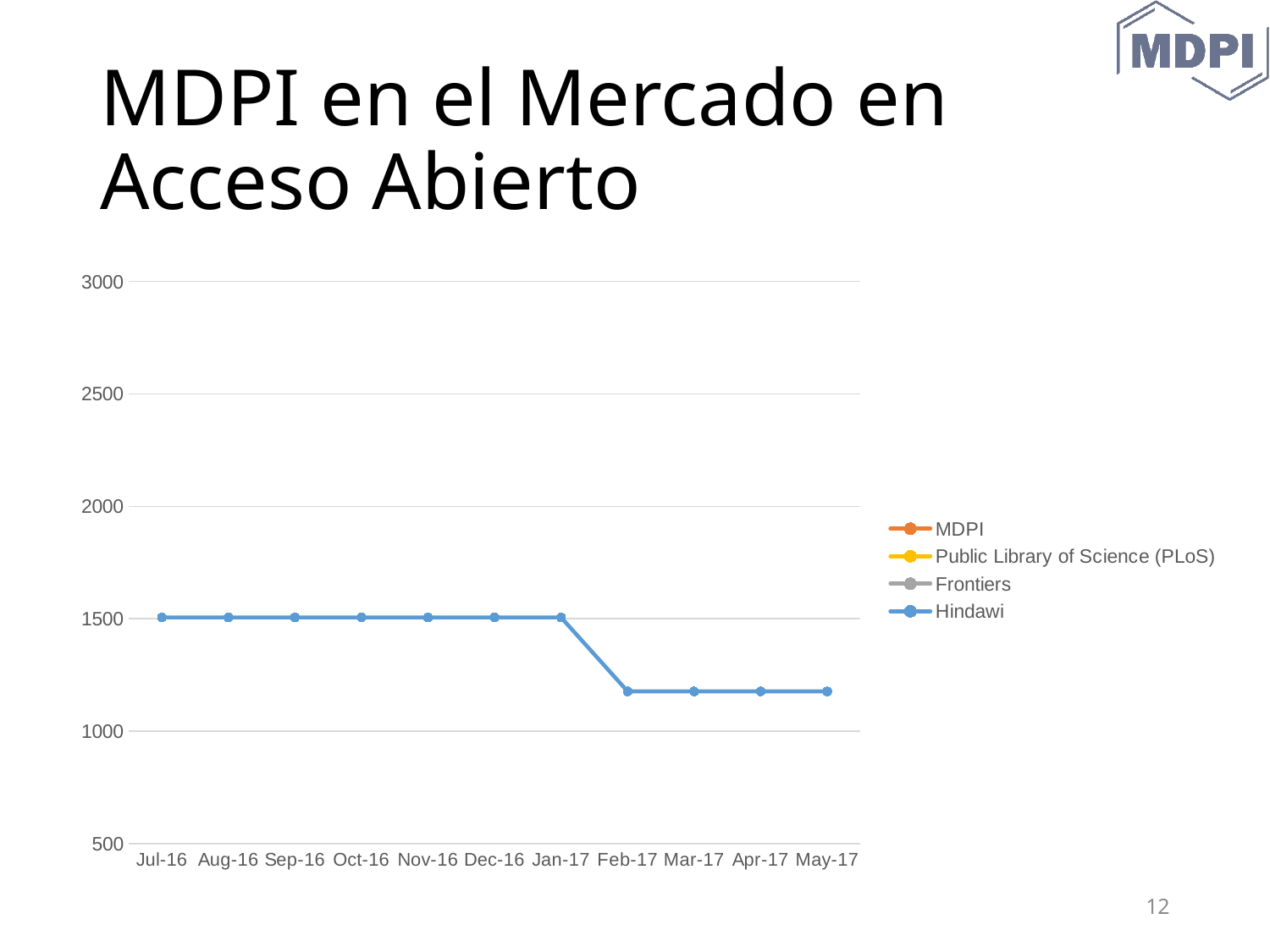
How many series does the legend list? 4 Which series is actually plotted as a line on the chart? Hindawi Which is larger for Hindawi, the value for Jan-17 or the value for Feb-17? Jan-17 What kind of chart is shown on the slide? line chart What colour is the Hindawi line in the legend? blue Is the Hindawi value for May-17 greater or less than 1000? greater Is the Hindawi value for Feb-17 greater or less than 1500? less Is the Hindawi value for Jul-16 greater or less than 2000? less Which is larger for Hindawi, the value for Apr-17 or the value for Sep-16? Sep-16 Does the Hindawi line rise or fall from Jul-16 to May-17? fall How many months are shown along the x axis? 11